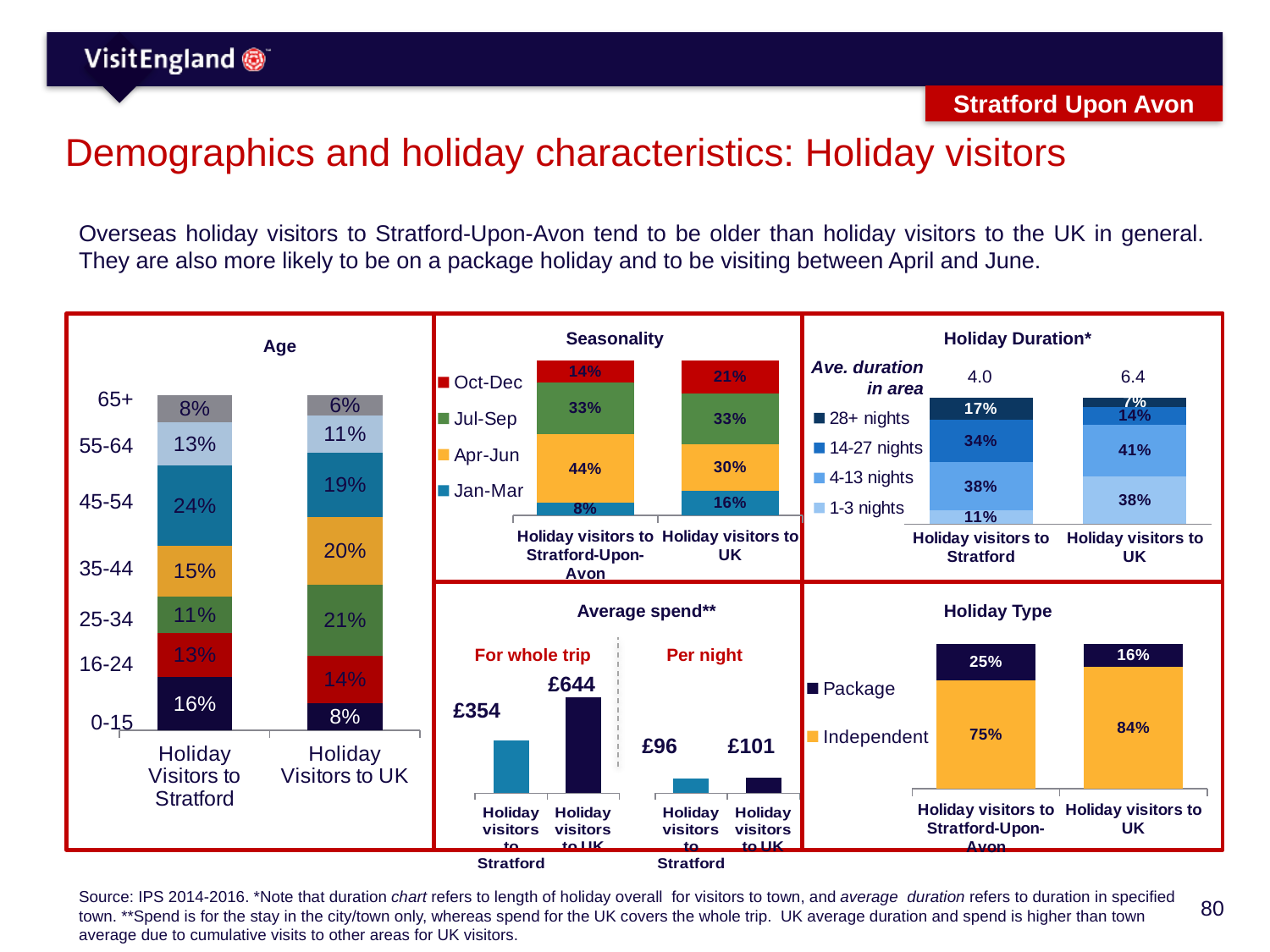
What type of chart is the Holiday Type chart? Stacked bar chart How many series does the legend of the Seasonality chart list? 4 In the Holiday Duration chart, what percentage of holiday visitors to the UK stay 4-13 nights? 41% In the Average spend chart, what is the average spend for the whole trip for holiday visitors to Stratford? £354 In the Holiday Duration chart, what is the average duration in area for holiday visitors to the UK? 6.4 In the Average spend chart, which is larger: per-night spend for holiday visitors to Stratford or for holiday visitors to the UK? Holiday visitors to UK In the Age chart, what percentage of holiday visitors to Stratford are aged 45-54? 24% In the Age chart, which age group is the largest for holiday visitors to Stratford? 45-54 In the Seasonality chart, what share of holiday visitors to Stratford-Upon-Avon visit in Apr-Jun? 44% In the Seasonality chart, what is the difference between the Apr-Jun share for holiday visitors to Stratford-Upon-Avon and for holiday visitors to the UK? 14 percentage points In the Age chart, what percentage of holiday visitors to the UK are aged 25-34? 21% In the Holiday Type chart, what percentage of holiday visitors to Stratford-Upon-Avon are on a package holiday? 25%